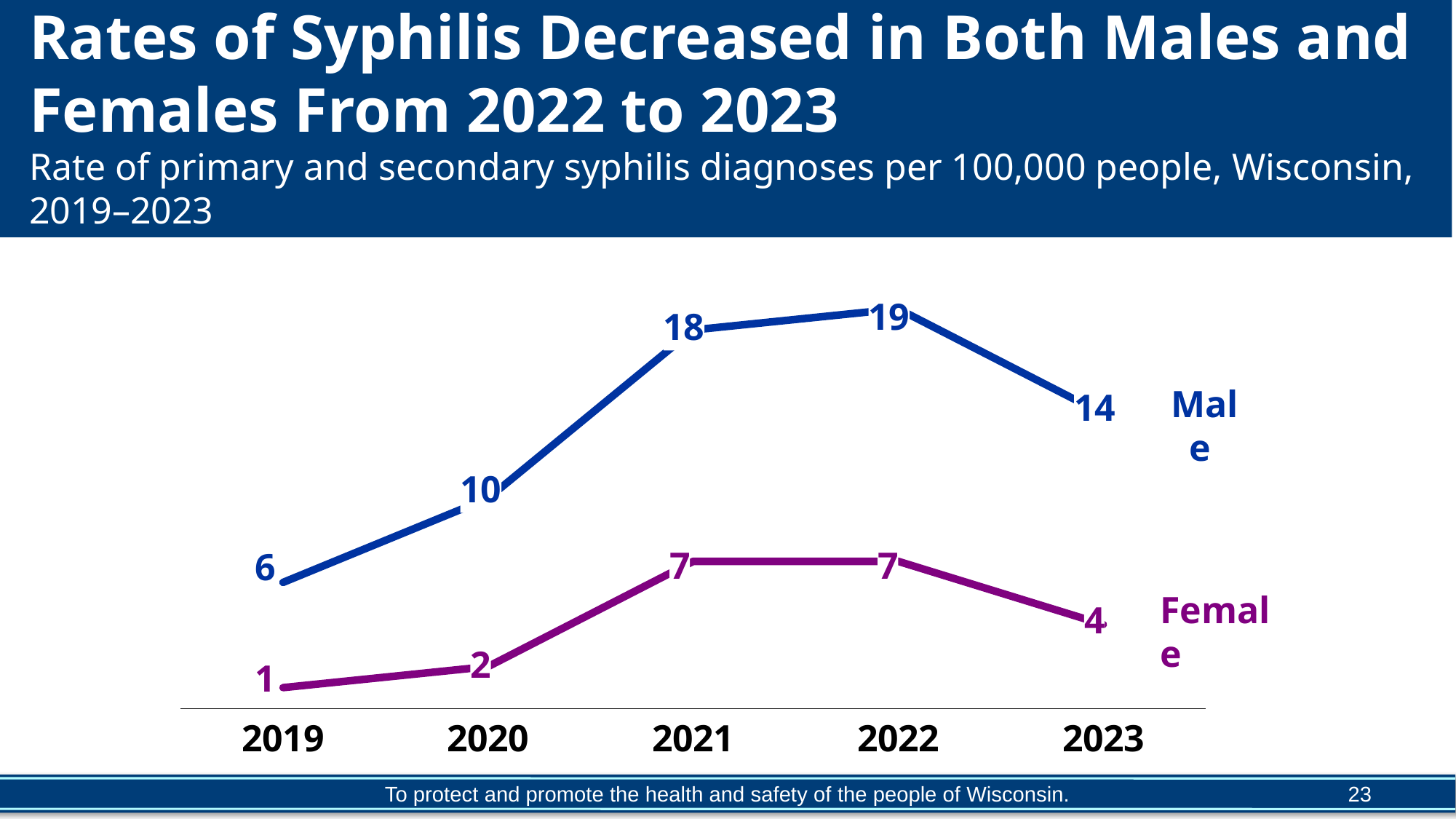
By how much did the male syphilis rate decrease from 2022 to 2023? 5 Which was higher in 2020, the male rate or the female rate? Male What was the syphilis rate for males in 2019? 6 What was the syphilis rate for males in 2022? 19 How many series are plotted on the chart? 2 Did the female syphilis rate rise or fall from 2019 to 2021? Rise How many years are shown on the x axis? 5 What kind of chart is shown on the slide? Line chart What is the difference between the male and female rates in 2021? 11 What was the syphilis rate for females in 2023? 4 In which year was the female syphilis rate lowest? 2019 In which year was the male syphilis rate highest? 2022